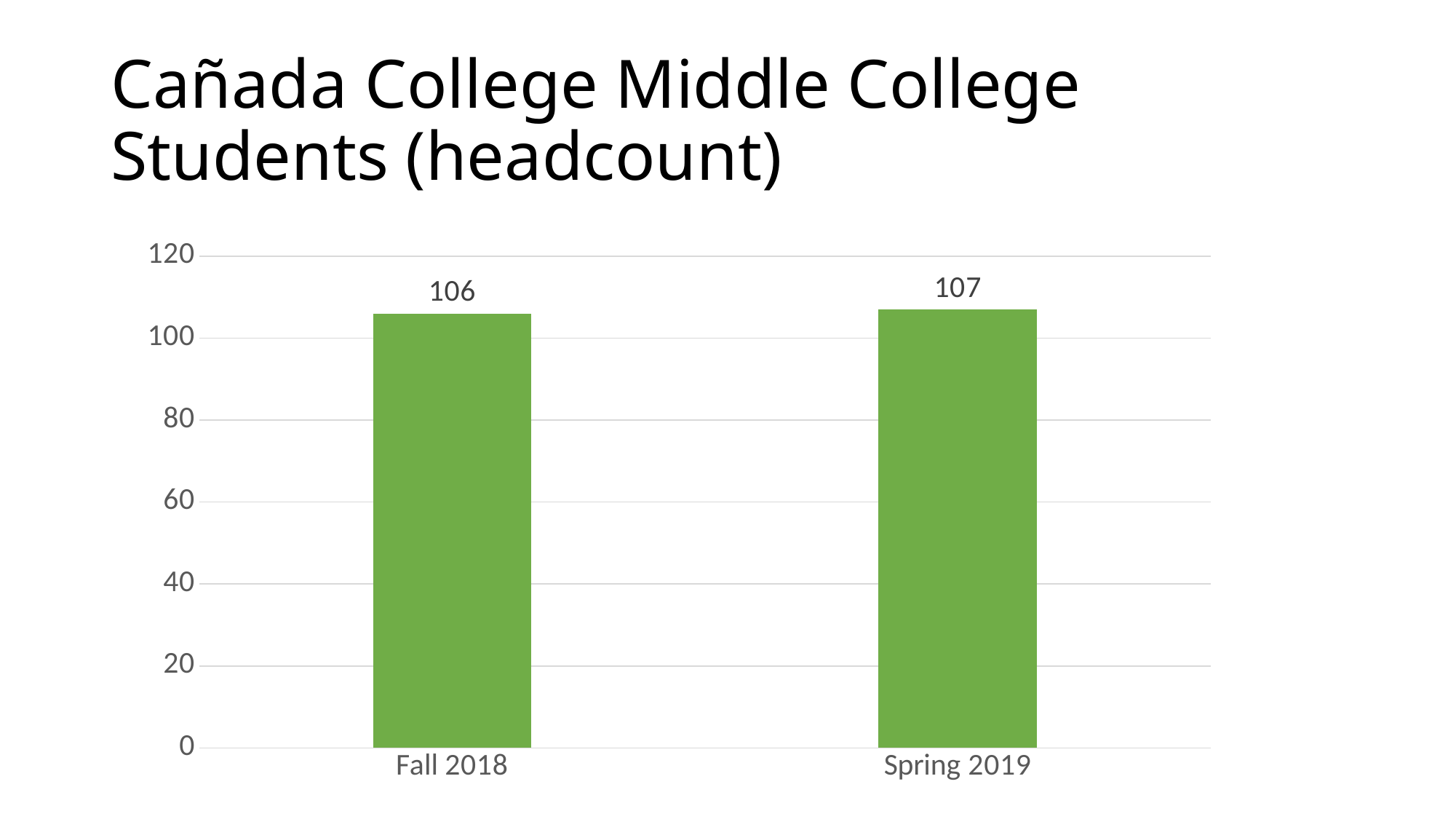
What is the difference in headcount between Spring 2019 and Fall 2018? 1 Is the value for Spring 2019 greater or less than 120? less Which term has the higher headcount? Spring 2019 What kind of chart is shown on the slide? bar chart What is the title of the slide? Cañada College Middle College Students (headcount) Does the headcount rise or fall from Fall 2018 to Spring 2019? rise Is the value for Fall 2018 greater or less than 100? greater What is the headcount for Spring 2019? 107 What is the headcount for Fall 2018? 106 Which term has the lower headcount? Fall 2018 How many terms are shown on the chart? 2 Is the headcount for Spring 2019 larger or smaller than the headcount for Fall 2018? larger